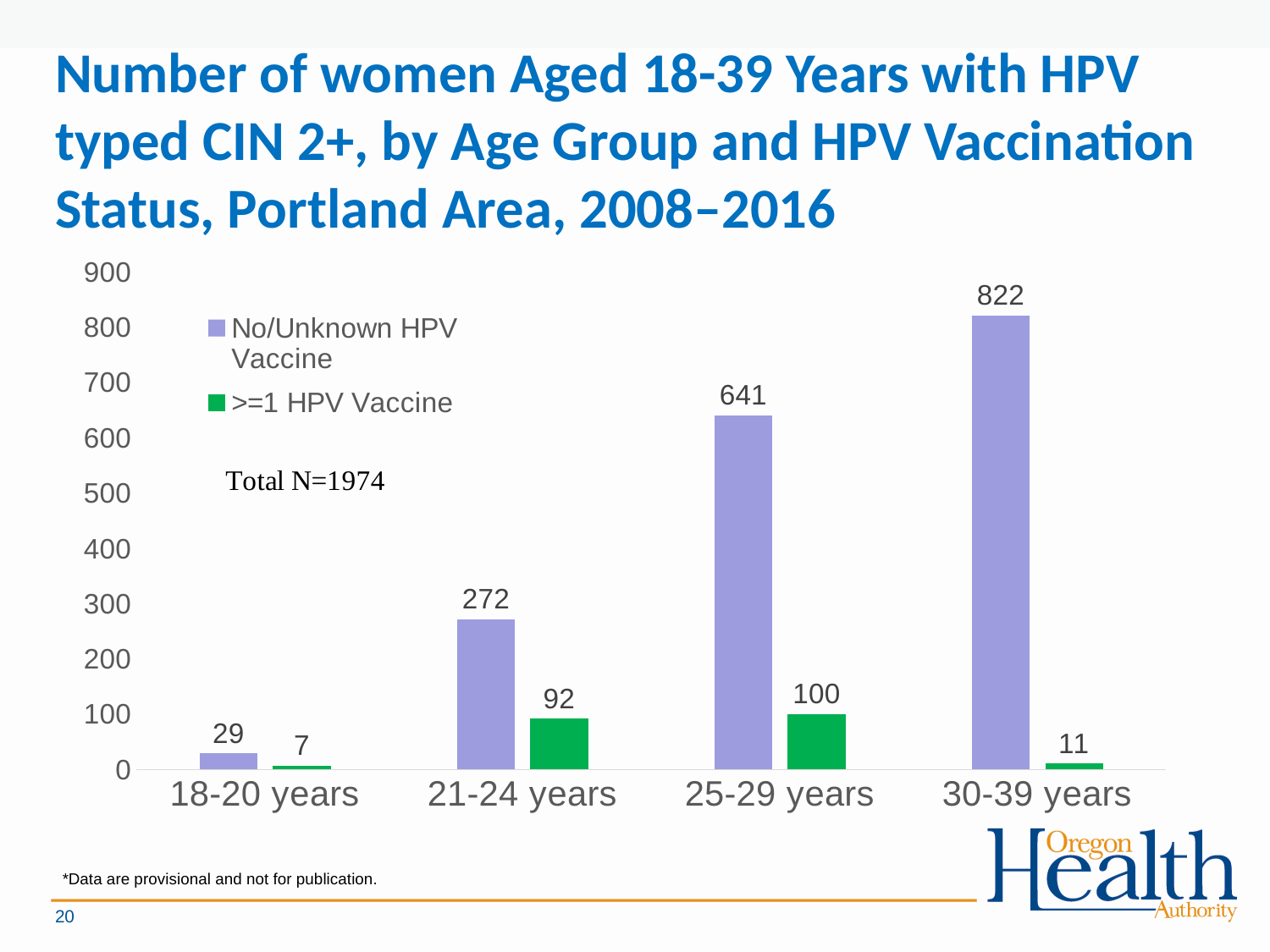
What is the value for No/Unknown HPV Vaccine in the 18-20 years age group? 29 How many age groups are shown on the x axis? 4 Which is larger: the >=1 HPV Vaccine value for 25-29 years or for 30-39 years? 25-29 years What kind of chart is shown on the slide? bar chart What is the value for >=1 HPV Vaccine in the 21-24 years age group? 92 What total N is stated on the chart? Total N=1974 Which age group has the highest value for No/Unknown HPV Vaccine? 30-39 years How many series does the legend list? 2 What is the value for No/Unknown HPV Vaccine in the 30-39 years age group? 822 What is the difference between the No/Unknown HPV Vaccine and >=1 HPV Vaccine values in the 25-29 years age group? 541 Is the value for No/Unknown HPV Vaccine in the 21-24 years age group greater or less than 300? less Which age group has the lowest value for >=1 HPV Vaccine? 18-20 years